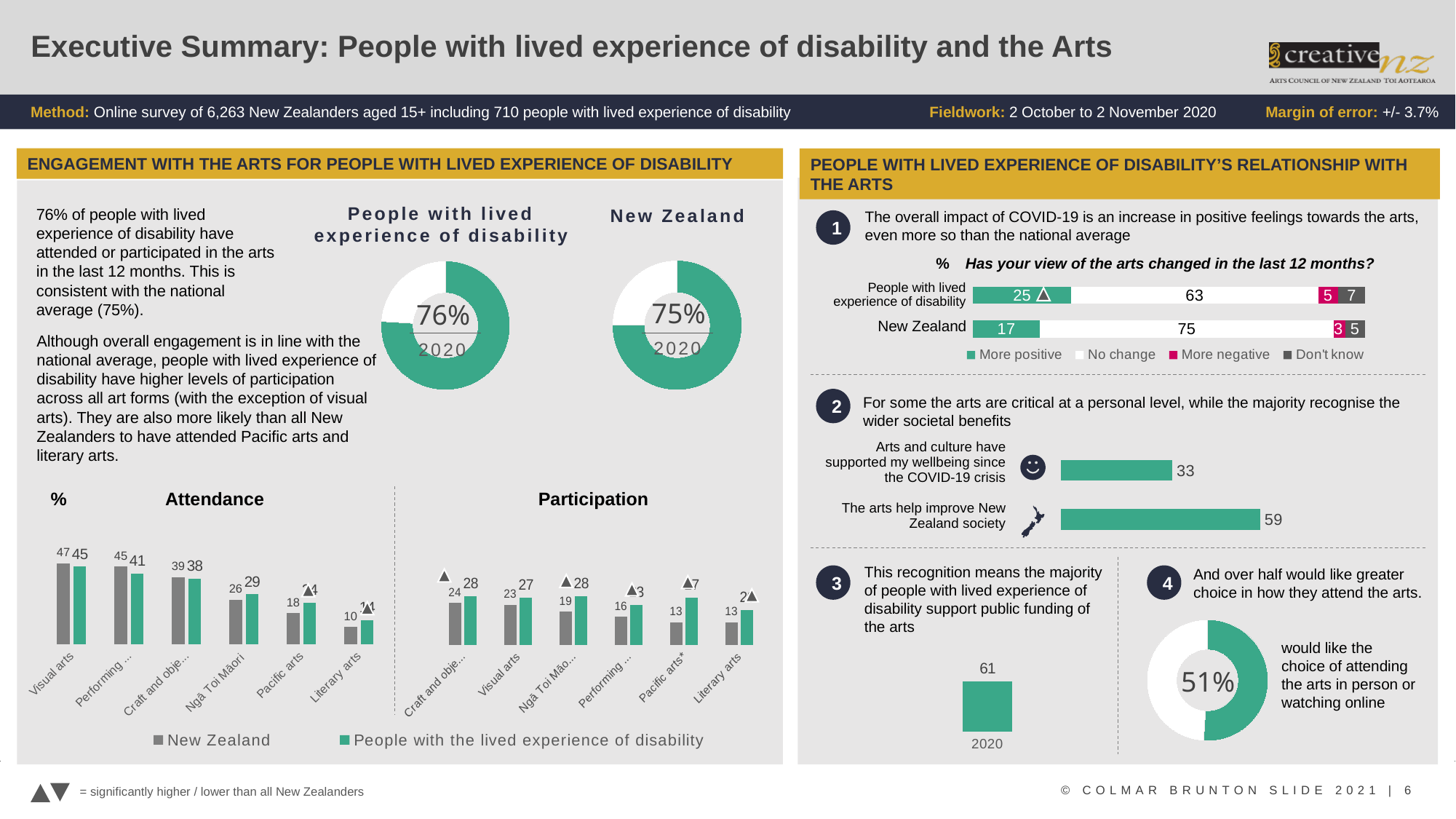
In the 'Has your view of the arts changed in the last 12 months?' chart, what is the 'No change' value for New Zealand? 75 In the Participation chart, how many art form categories are shown? 6 In the 'Has your view of the arts changed in the last 12 months?' chart, how many series does the legend list? 4 In the chart under point 2, what is the value for 'The arts help improve New Zealand society'? 59 In the 'Has your view of the arts changed in the last 12 months?' chart, what percentage of people with lived experience of disability said 'More positive'? 25 In the 'Has your view of the arts changed in the last 12 months?' chart, what is the difference between the 'More positive' values for people with lived experience of disability and New Zealand? 8 What percentage is shown in the 'People with lived experience of disability' donut chart? 76% In the Participation chart, what is the value for people with the lived experience of disability for Visual arts? 27 In the chart under point 2, which statement has the lower value? Arts and culture have supported my wellbeing since the COVID-19 crisis In the Attendance chart, what is the value for people with the lived experience of disability for Ngā Toi Māori? 29 In the Attendance chart, what is the New Zealand value for Visual arts? 47 In the Attendance chart, which art form has the highest attendance for New Zealand? Visual arts